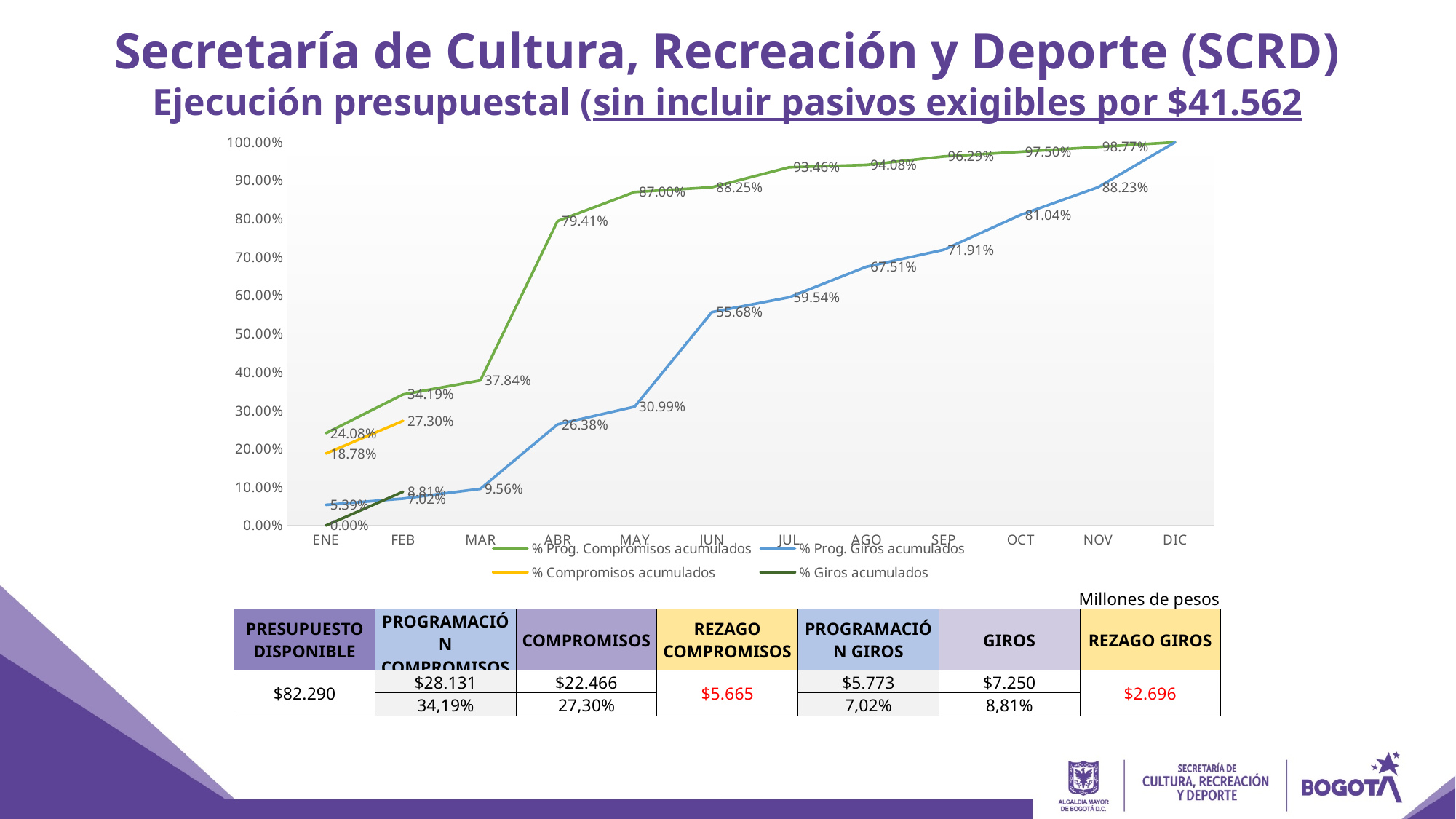
What is the value of % Prog. Compromisos acumulados for ABR? 79.41% How many months are shown on the x axis of the chart? 12 What is the value of % Compromisos acumulados for FEB? 27.30% Which month has the lowest value for % Prog. Compromisos acumulados? ENE What is the value of % Prog. Giros acumulados for JUN? 55.68% What is the difference between % Prog. Compromisos acumulados and % Compromisos acumulados in FEB? 6.89% How many series does the chart legend list? 4 What kind of chart is shown on the slide? line chart Which is larger in FEB: % Prog. Giros acumulados or % Giros acumulados? % Giros acumulados What is the value of % Giros acumulados for ENE? 0.00% Does the % Prog. Giros acumulados series rise or fall from ENE to DIC? rise Is the value of % Prog. Giros acumulados for DIC greater or less than 90.00%? greater